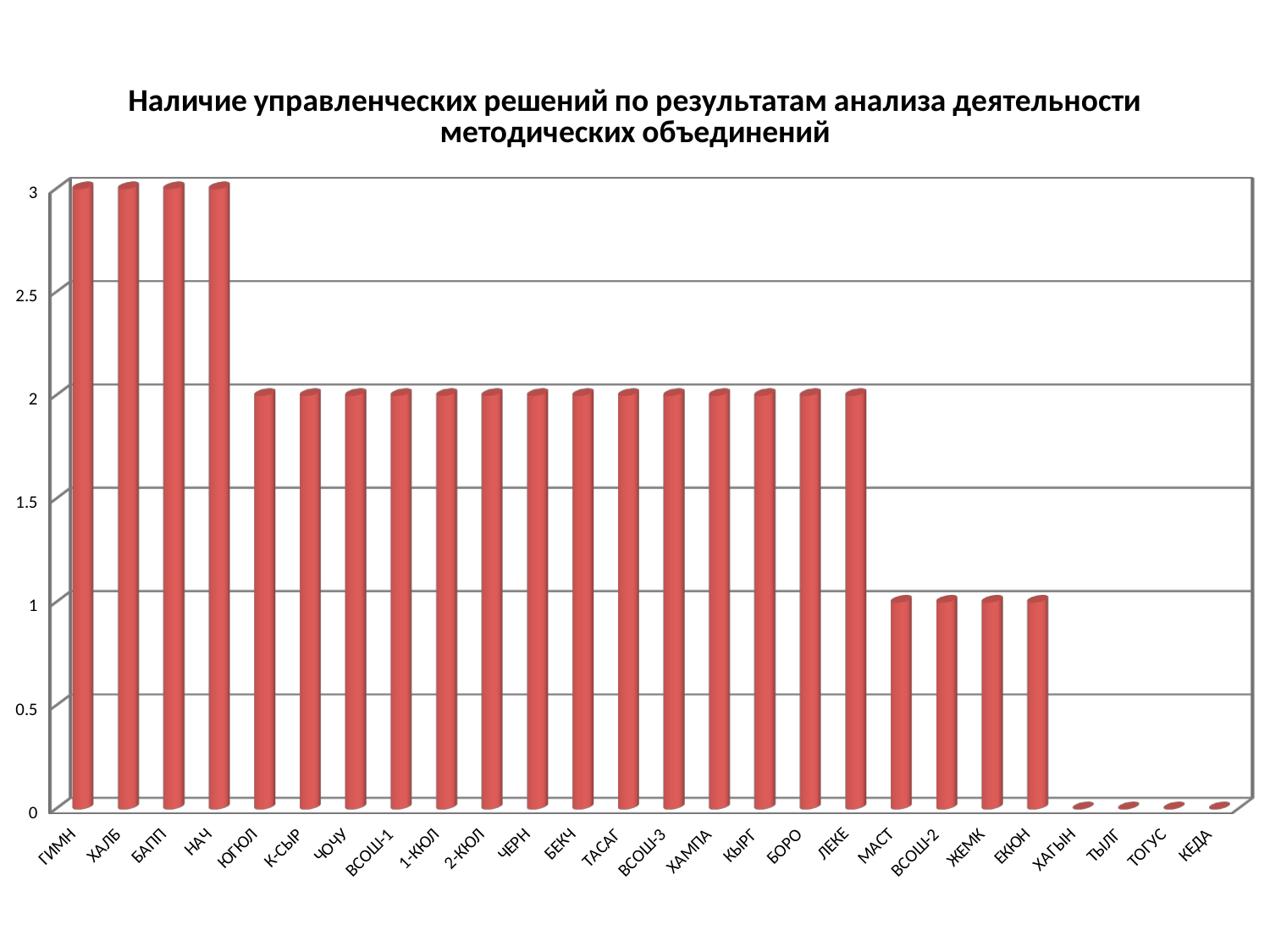
What is the value for ЧЕРН? 2 Which is larger, the value for НАЧ or the value for МАСТ? НАЧ What is the value for ЖЕМК? 1 What kind of chart is shown on the slide? Bar chart What is the difference between the value for ХАЛБ and the value for ЕКЮН? 2 What is the value for ГИМН? 3 Is the value for БОРО greater or less than 1.5? greater Is the value for ВСОШ-2 greater or less than 1.5? less Do the values rise or fall from left to right along the x axis? Fall What is the value for КЕДА? 0 How many categories are shown on the x axis? 26 What is the title of the chart? Наличие управленческих решений по результатам анализа деятельности методических объединений